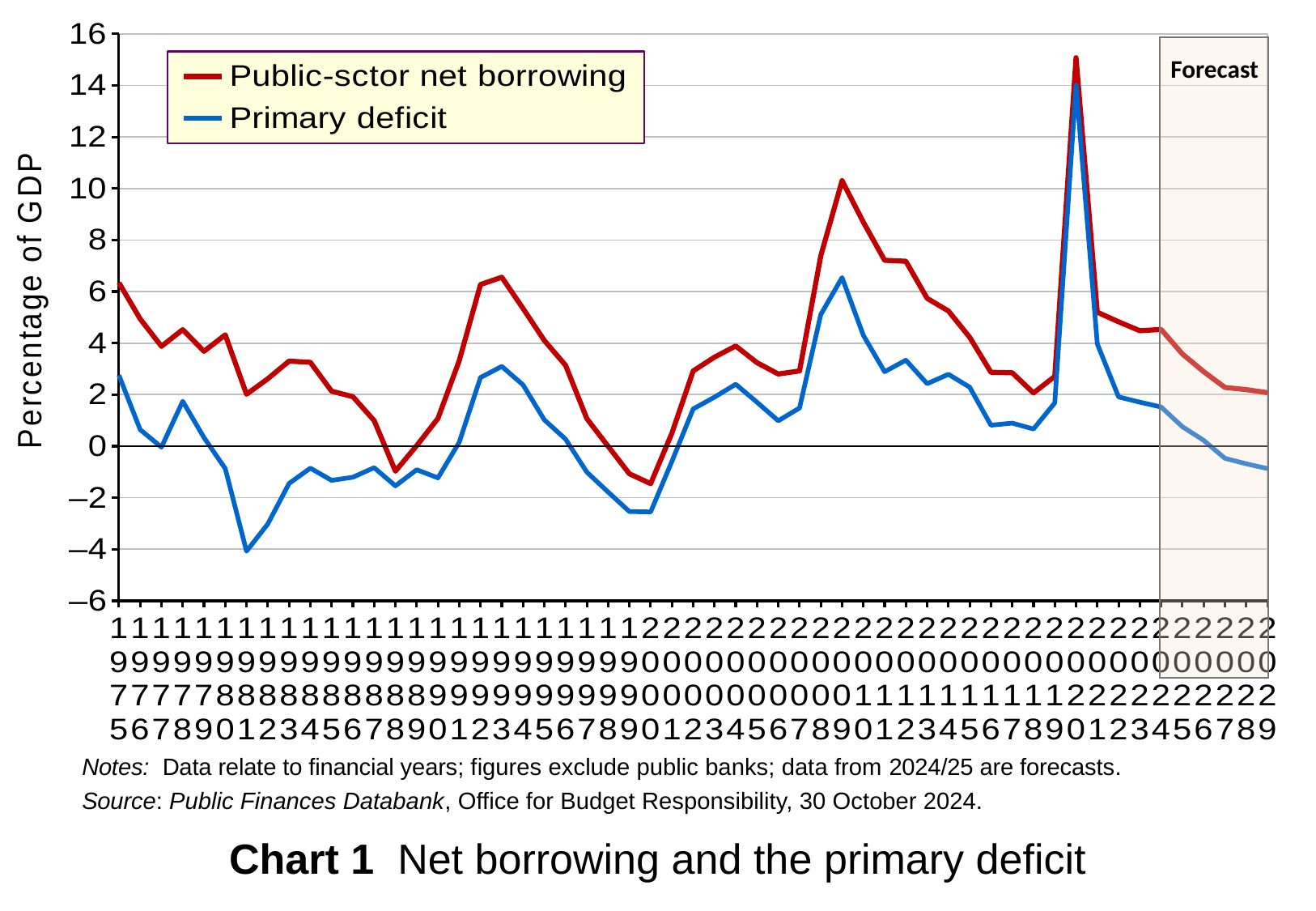
What are the two series named in the legend? Public-sctor net borrowing and Primary deficit Is the value for the primary deficit in 1981 greater or less than -2? less Over the forecast period from 2024 to 2029, does public-sector net borrowing rise or fall? Fall What kind of chart is shown on the slide? Line chart In which year does public-sector net borrowing reach its highest value? 2020 Is the value for public-sector net borrowing in 2009 greater or less than 8? greater Which is larger: public-sector net borrowing in 2009 or in 2020? 2020 Is the value for the primary deficit in 2029 greater or less than 0? less In which year does the primary deficit reach its lowest value? 1981 How many series does the legend list? 2 What is the label on the vertical axis? Percentage of GDP